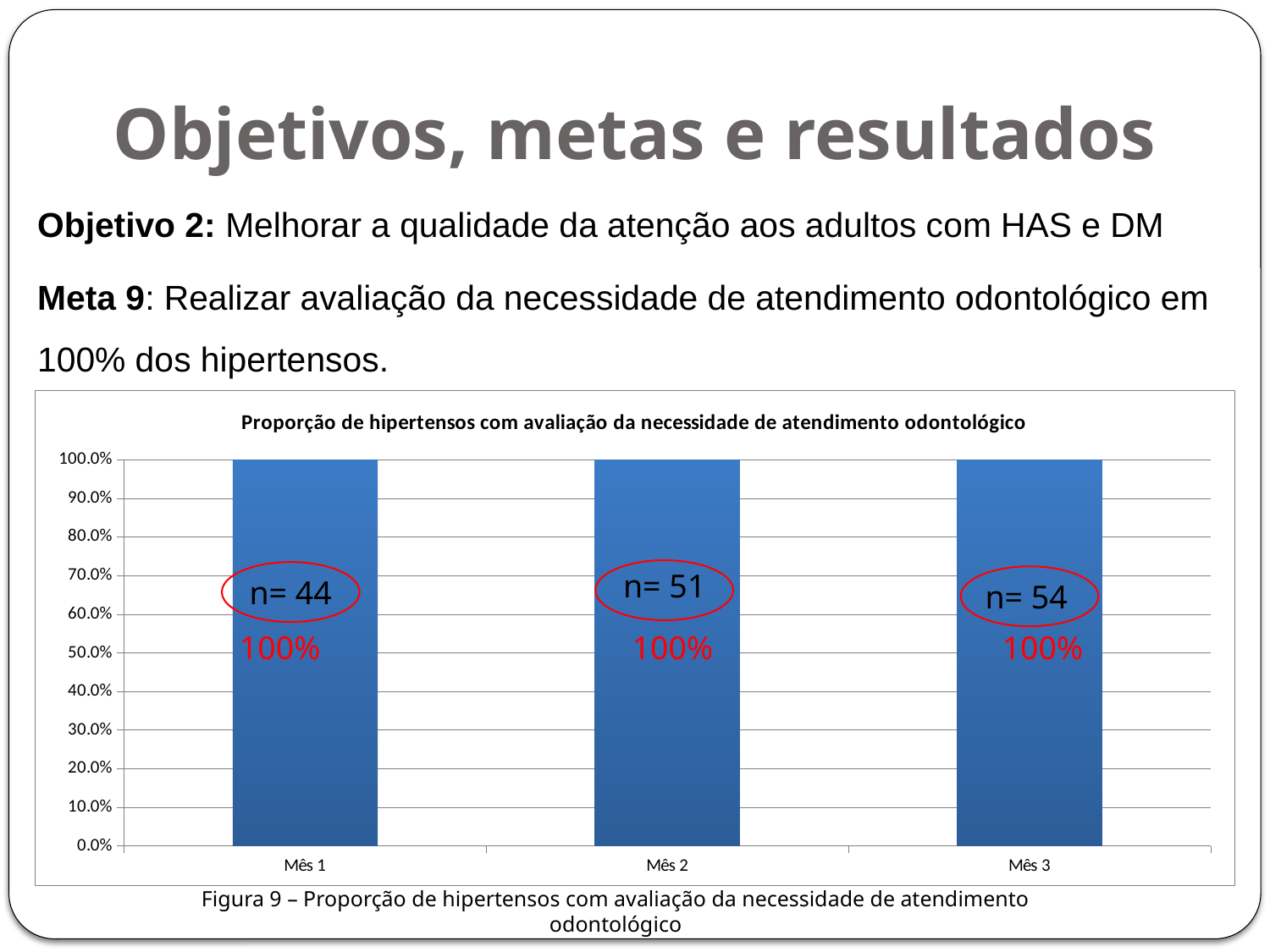
What is the value for Mês 2? 100% What is the value for Mês 1? 100% What is the n value annotated on the bar for Mês 2? n= 51 What is the n value annotated on the bar for Mês 1? n= 44 What kind of chart is shown? bar chart What is the title of the chart? Proporção de hipertensos com avaliação da necessidade de atendimento odontológico What is the n value annotated on the bar for Mês 3? n= 54 Is the value for Mês 2 greater or less than 50.0%? greater Do the values rise, fall or stay the same from Mês 1 to Mês 3? stay the same What is the value for Mês 3? 100% What is the difference between the values for Mês 3 and Mês 1? 0% How many categories are shown on the x axis? 3